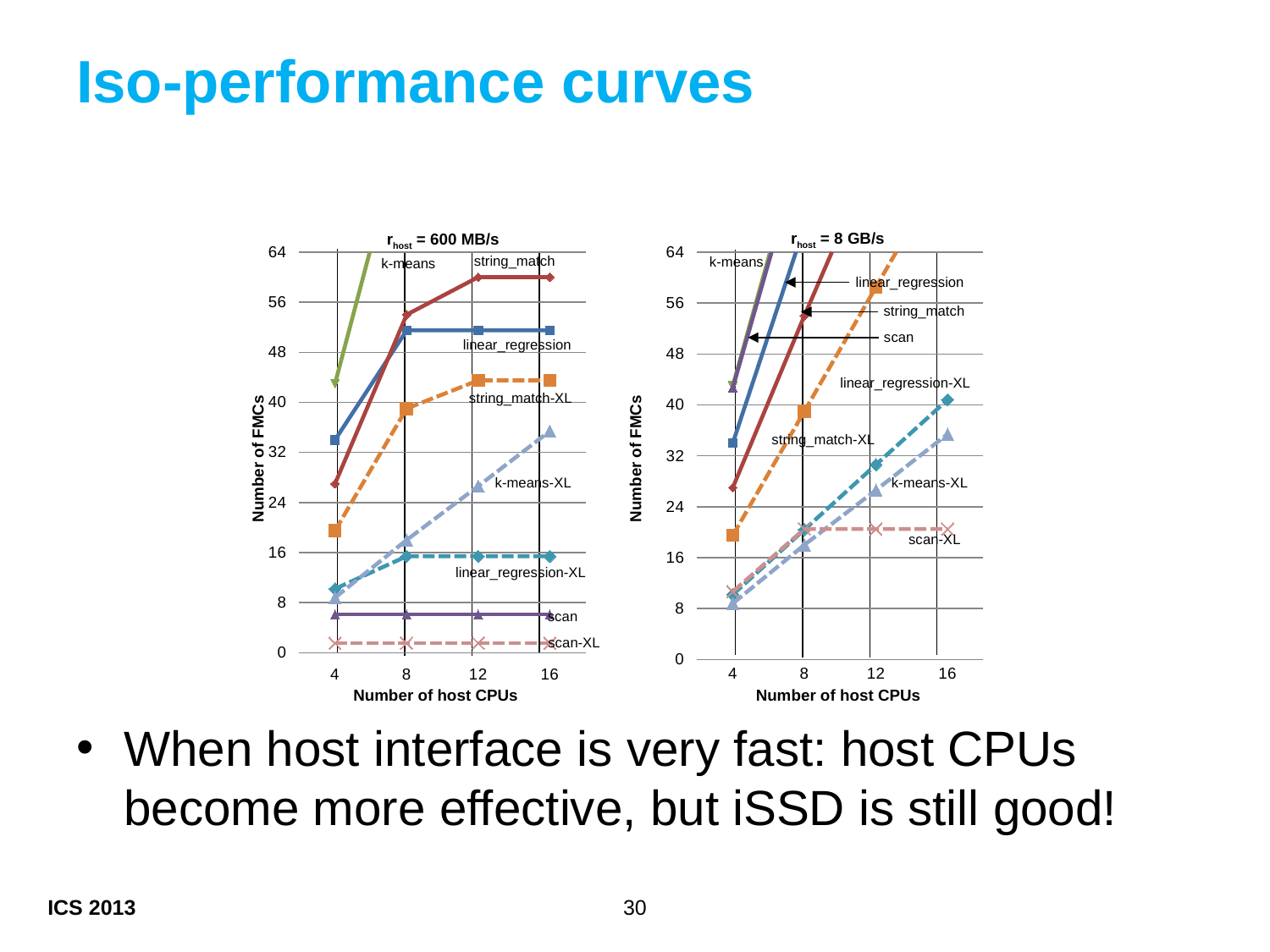
In the right chart (r_host = 8 GB/s), which is higher at 16 host CPUs: k-means-XL or scan-XL? k-means-XL In the left chart (r_host = 600 MB/s), is the value for string_match-XL at 4 host CPUs greater or less than 16? greater How many host CPU values are marked on the x axis of the right chart (r_host = 8 GB/s)? 4 In the right chart (r_host = 8 GB/s), is the value for string_match at 4 host CPUs greater or less than 24? greater What type of chart is shown on the left (r_host = 600 MB/s)? line chart In the left chart (r_host = 600 MB/s), is the value for scan-XL at 16 host CPUs greater or less than 8? less In the left chart (r_host = 600 MB/s), which is higher at 16 host CPUs: string_match or linear_regression? string_match What is the y-axis label of the left chart (r_host = 600 MB/s)? Number of FMCs In the left chart (r_host = 600 MB/s), does the k-means-XL line rise or fall as the number of host CPUs increases? rise